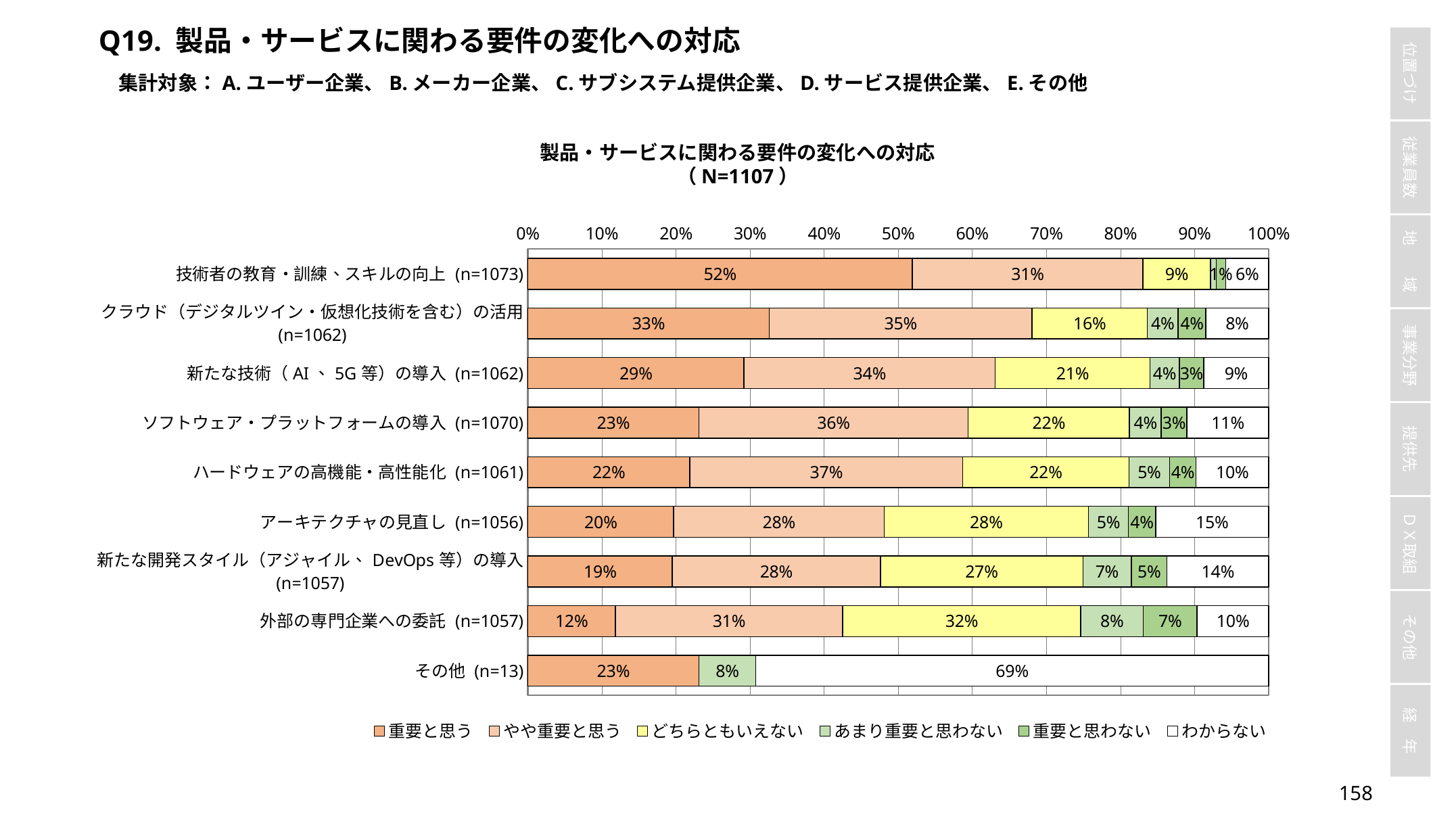
Which is larger: the やや重要と思う value for ハードウェアの高機能・高性能化 or for アーキテクチャの見直し? ハードウェアの高機能・高性能化 How many series does the legend list? 6 What is the どちらともいえない value for 外部の専門企業への委託? 32% What is the わからない value for その他 (n=13)? 69% What kind of chart is shown on the slide? Stacked bar chart What is the N shown in the chart title? N=1107 What is the わからない value for アーキテクチャの見直し? 15% What is the difference between the 重要と思う values for クラウド（デジタルツイン・仮想化技術を含む）の活用 and 新たな技術（AI、5G等）の導入? 4% How many categories (rows) are plotted in the chart? 9 What is the 重要と思う value for 技術者の教育・訓練、スキルの向上? 52% Which category has the highest 重要と思う value? 技術者の教育・訓練、スキルの向上 Which category has the lowest 重要と思う value? 外部の専門企業への委託